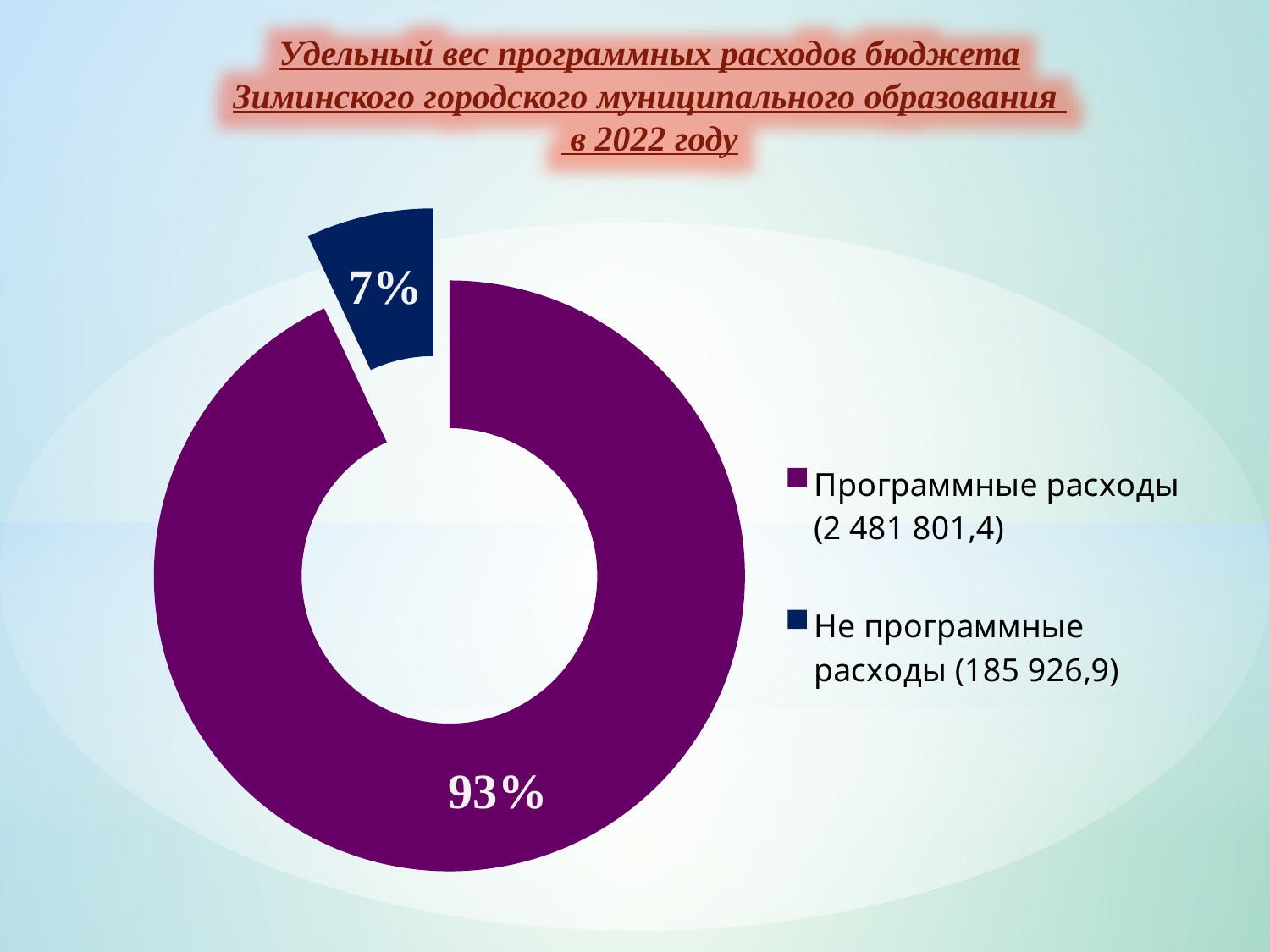
What kind of chart is shown on the slide? Doughnut (pie) chart What amount is shown in the legend for "Программные расходы"? 2 481 801,4 How many slices does the chart have? 2 What share of the chart is labelled "Программные расходы"? 93% What share of the chart is labelled "Не программные расходы"? 7% Which is larger: the share for "Программные расходы" or for "Не программные расходы"? Программные расходы Which category has the largest share of the chart? Программные расходы What colour is the slice for "Не программные расходы"? Dark blue What amount is shown in the legend for "Не программные расходы"? 185 926,9 What is the difference in percentage points between the two slices? 86 Which year does the chart title refer to? 2022 Which category has the smallest share of the chart? Не программные расходы